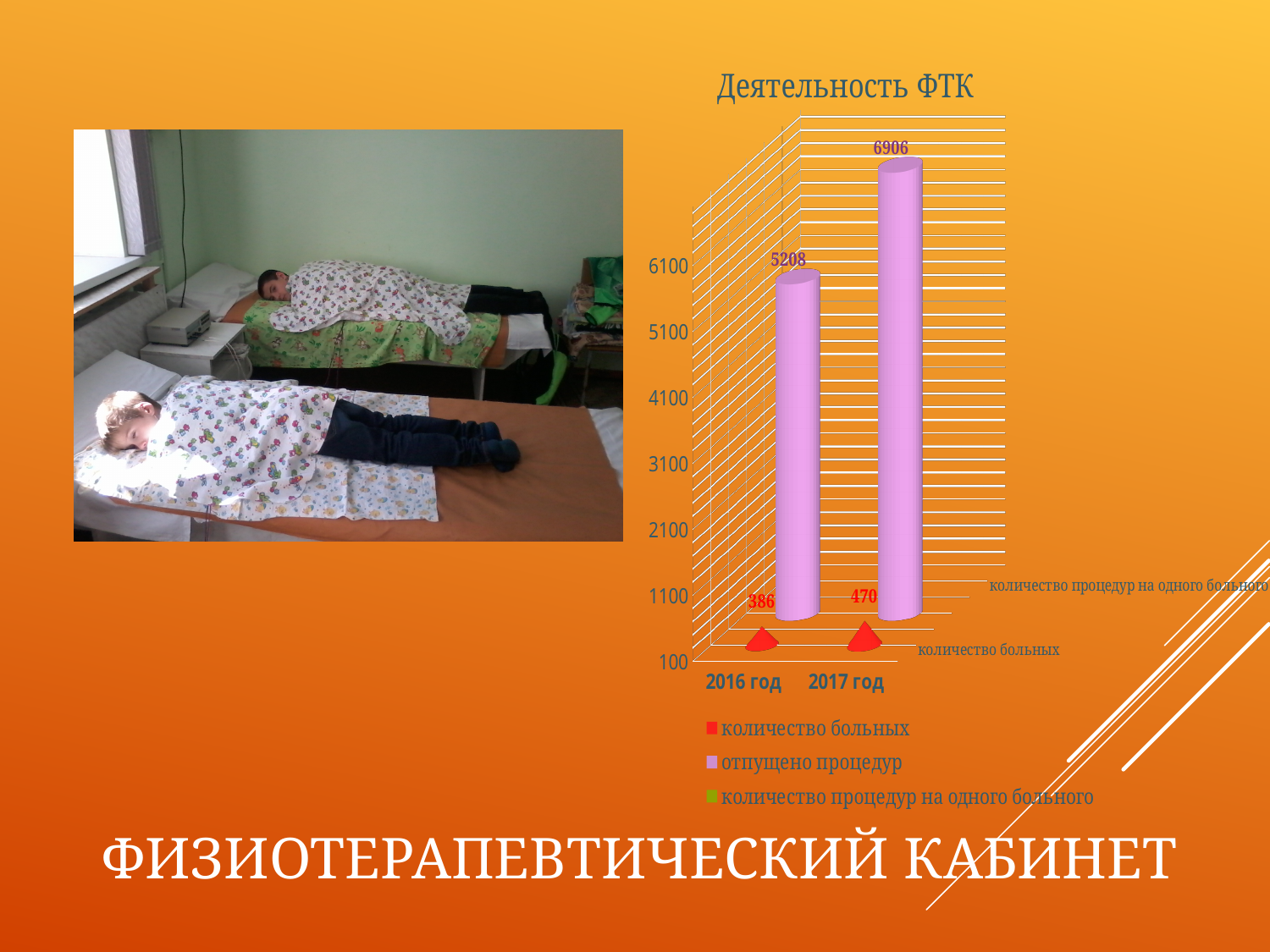
What is the value of 'количество больных' for 2017 год? 470 What is the value of 'отпущено процедур' for 2016 год? 5208 What kind of chart is shown on the slide? bar chart What is the value of 'количество больных' for 2016 год? 386 What is the value of 'отпущено процедур' for 2017 год? 6906 What is the difference in 'количество больных' between 2017 год and 2016 год? 84 Which year has the higher value for 'отпущено процедур'? 2017 год What is the title of the chart? Деятельность ФТК By how much did 'отпущено процедур' increase from 2016 год to 2017 год? 1698 How many series does the chart legend list? 3 How many year categories are shown on the x axis of the chart? 2 Does 'отпущено процедур' rise or fall from 2016 год to 2017 год? rise